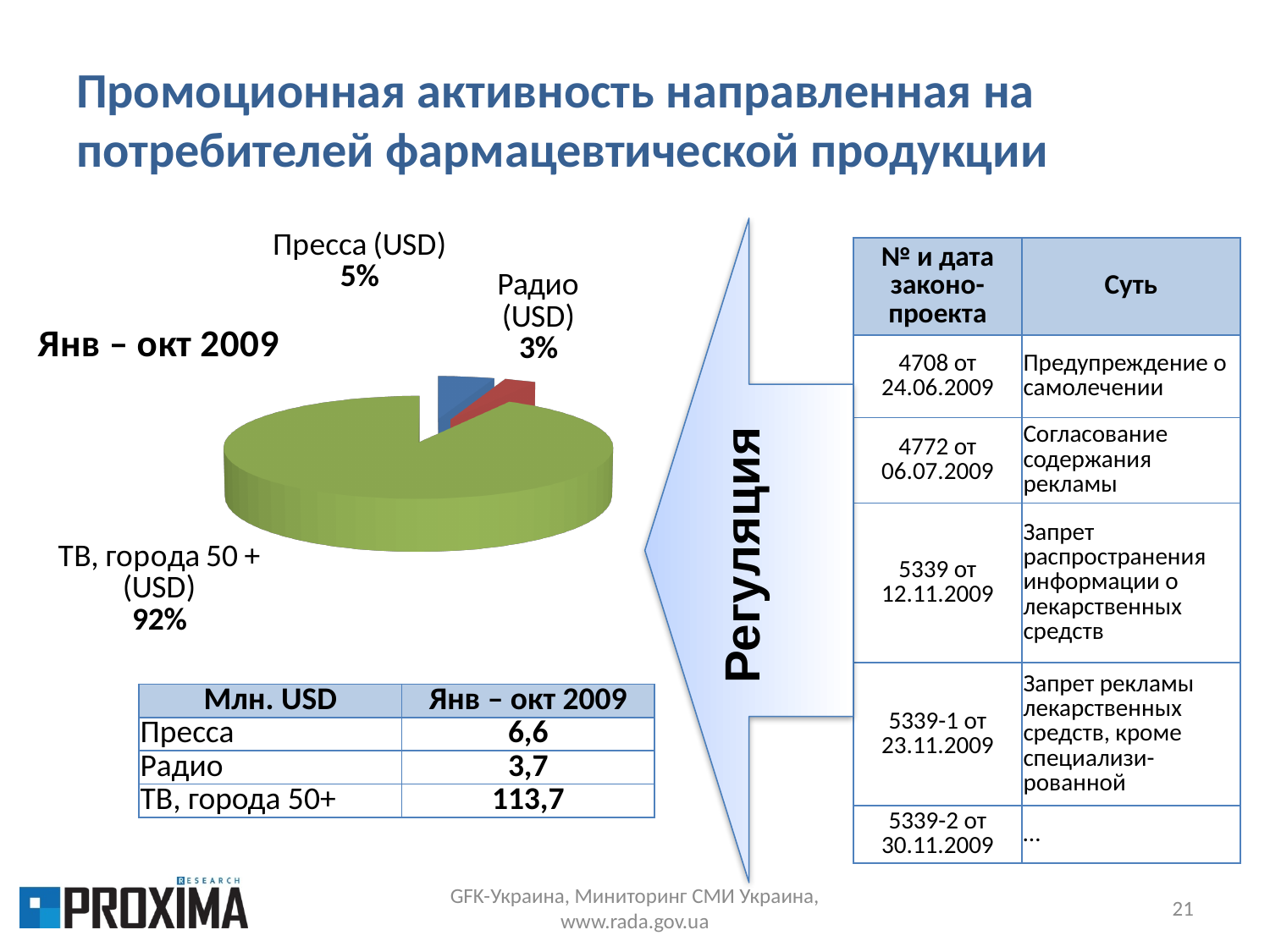
What kind of chart is shown on the slide? pie chart What colour is the ТВ, города 50+ (USD) slice in the pie chart? green Which slice of the pie chart is the smallest? Радио (USD) What share of the pie chart does ТВ, города 50+ (USD) account for? 92% What share of the pie chart does Пресса (USD) account for? 5% What is the difference in percentage points between the Пресса (USD) and Радио (USD) slices? 2% What share of the pie chart does Радио (USD) account for? 3% Which slice of the pie chart is the largest? ТВ, города 50+ (USD) What period does the pie chart's title refer to? Янв – окт 2009 How many slices does the pie chart have? 3 Which slice is larger in the pie chart, Пресса (USD) or Радио (USD)? Пресса (USD) What is the difference in percentage points between the ТВ, города 50+ (USD) slice and the Пресса (USD) slice? 87%